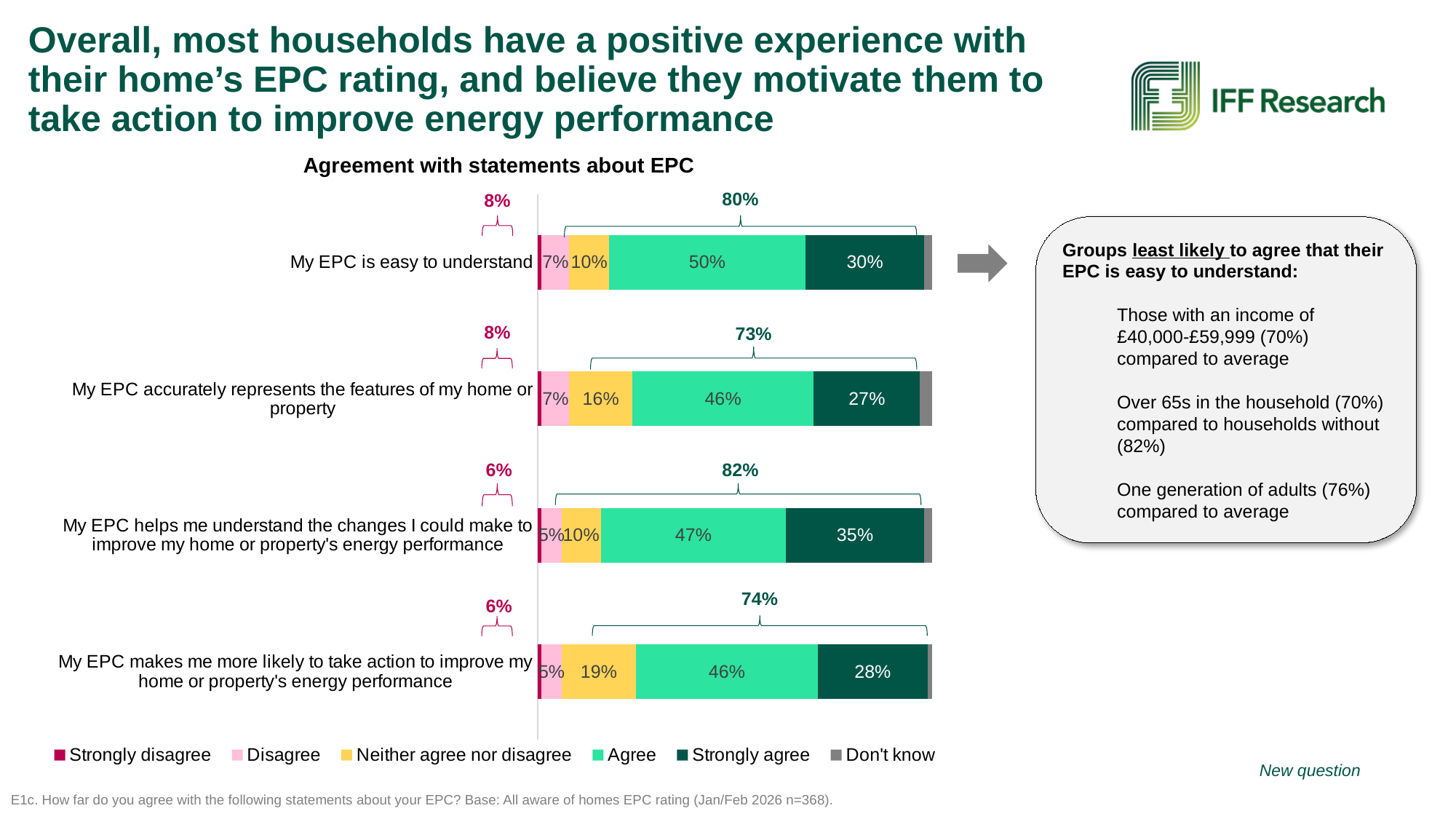
Which statement has the highest 'Strongly agree' percentage? My EPC helps me understand the changes I could make to improve my home or property's energy performance What colour represents 'Strongly agree' in the legend? Dark green Which statement has the lowest combined agreement percentage shown above its bar? My EPC accurately represents the features of my home or property What percentage 'Agree' that their EPC accurately represents the features of their home or property? 46% What type of chart is shown under 'Agreement with statements about EPC'? Stacked bar chart What is the difference between the 'Agree' value for 'My EPC is easy to understand' and the 'Agree' value for 'My EPC accurately represents the features of my home or property'? 4% What is the combined agreement (Agree plus Strongly agree) shown above the bar for 'My EPC helps me understand the changes I could make to improve my home or property's energy performance'? 82% Is the 'Strongly agree' value larger for 'My EPC is easy to understand' or for 'My EPC makes me more likely to take action to improve my home or property's energy performance'? My EPC is easy to understand What percentage of respondents 'Strongly agree' that their EPC is easy to understand? 30% What is the 'Neither agree nor disagree' value for 'My EPC makes me more likely to take action to improve my home or property's energy performance'? 19% How many statements are plotted in the 'Agreement with statements about EPC' chart? 4 How many series does the legend of the 'Agreement with statements about EPC' chart list? 6